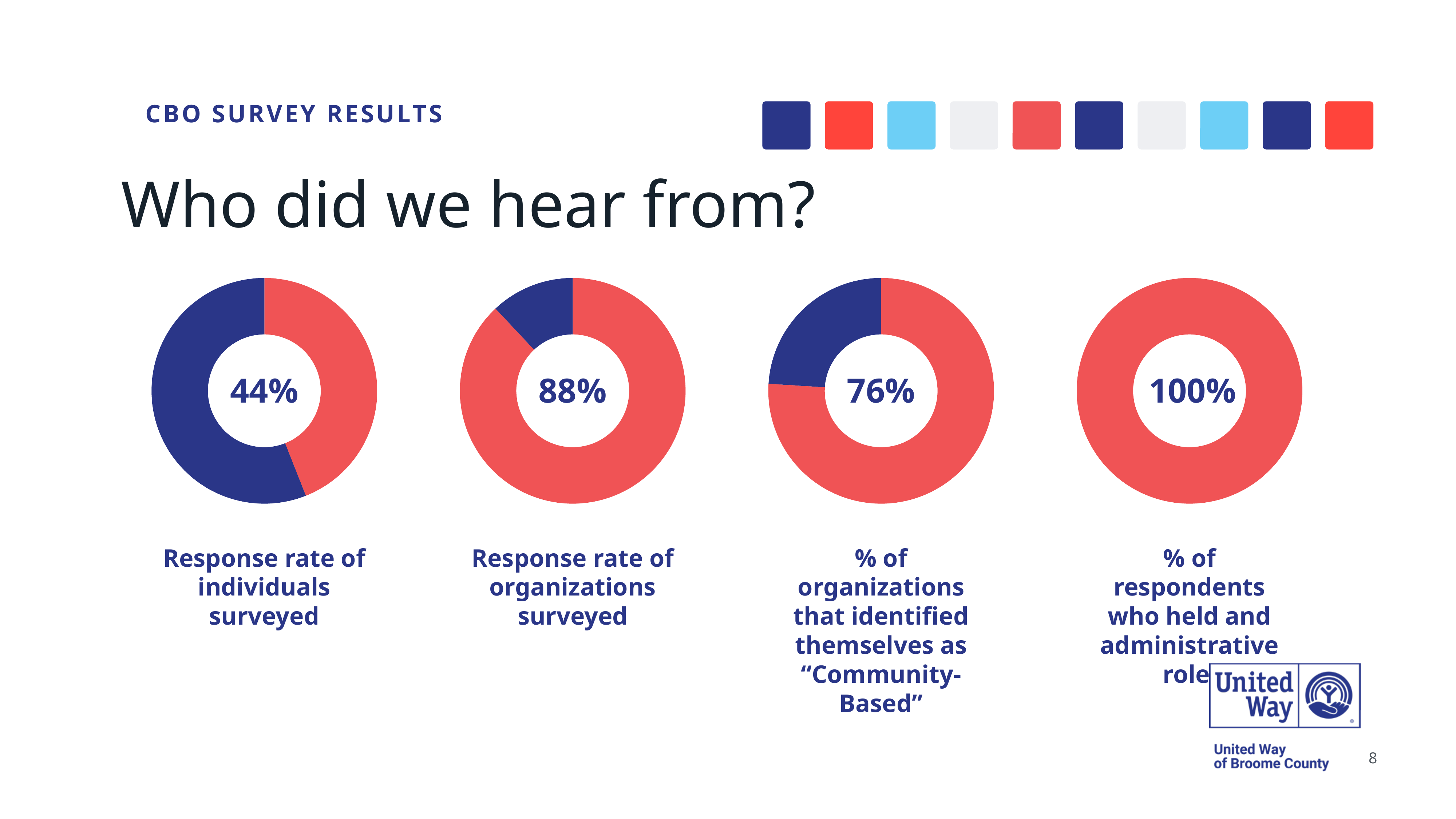
What kind of chart is used to display the percentages on this slide? Donut (pie) chart What value is shown in the centre of the donut chart labelled "Response rate of individuals surveyed"? 44% What percentage of organizations identified themselves as "Community-Based", according to the third donut chart? 76% What colour is the filled (value) portion of each donut chart? Red What value is shown in the donut chart for the % of respondents who held an administrative role? 100% Which of the four donut charts shows the lowest percentage? Response rate of individuals surveyed (44%) What value is shown in the centre of the donut chart labelled "Response rate of organizations surveyed"? 88% What is the difference between the % of respondents who held an administrative role and the % of organizations that identified as "Community-Based"? 24% Which is larger: the response rate of organizations surveyed or the % of organizations that identified as "Community-Based"? Response rate of organizations surveyed (88%) How many donut charts are shown on the slide? 4 Which of the four donut charts shows the highest percentage? % of respondents who held an administrative role (100%) What is the difference between the response rate of organizations surveyed and the response rate of individuals surveyed? 44%